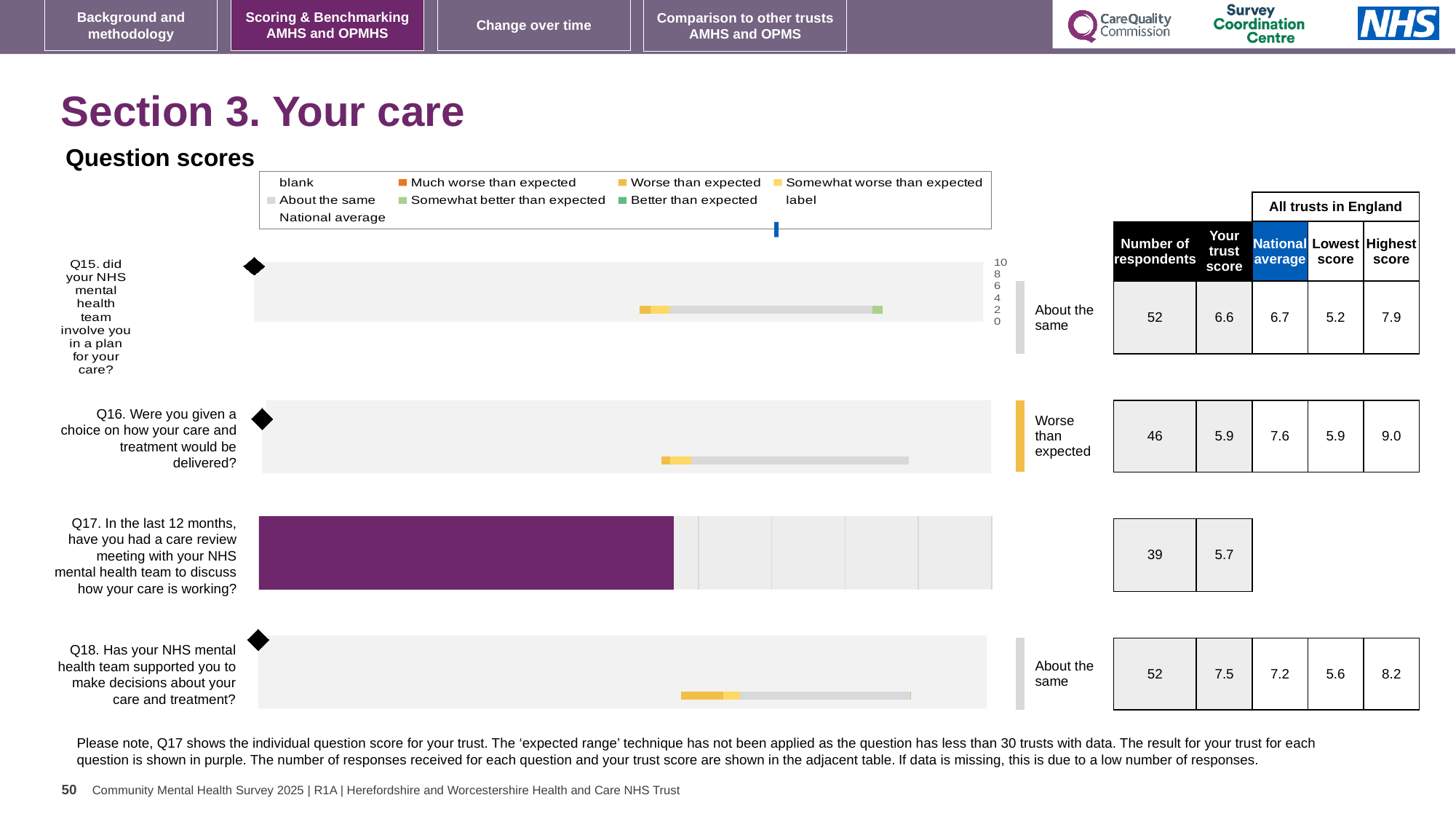
What kind of chart is used to show the question scores? Bar chart How many respondents answered Q17 (care review meeting in the last 12 months)? 39 What is the national average score for Q18 (supported to make decisions about your care and treatment)? 7.2 What is the difference between the national average and the trust score for Q16? 1.7 For Q15, is the trust score higher or lower than the national average? Lower What is the trust score for Q16 (Were you given a choice on how your care and treatment would be delivered)? 5.9 What is the highest score among all trusts in England for Q16? 9.0 How many questions are plotted in the Question scores chart? 4 What is the difference between the highest score and the lowest score for Q18? 2.6 Which question has the lowest trust score? Q17 Which question has the highest trust score? Q18 Which question is rated 'Worse than expected'? Q16